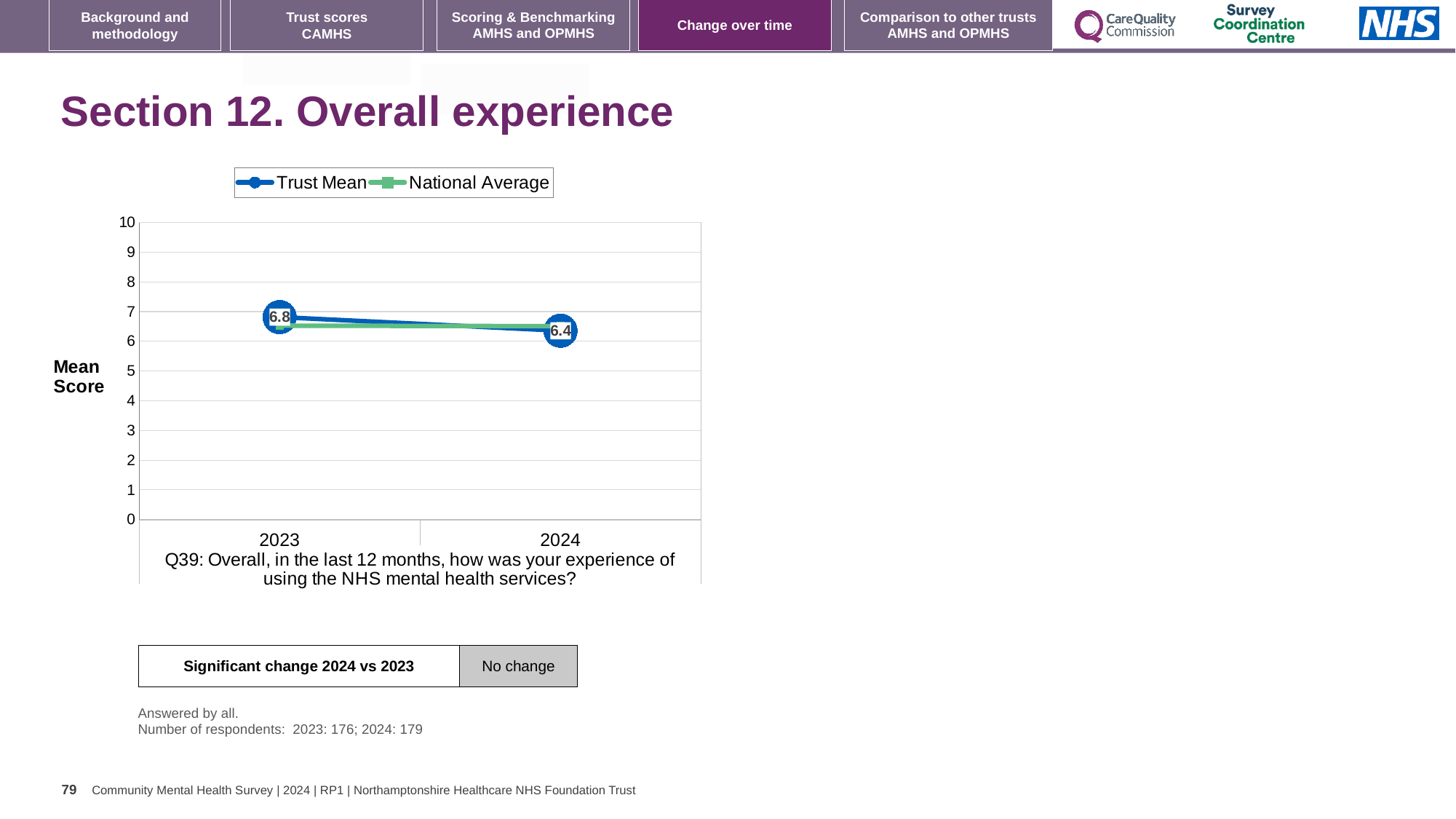
By how much did the Trust Mean change from 2023 to 2024? 0.4 Is the National Average value for 2024 greater or less than 6? greater What is the label on the y axis of the chart? Mean Score How many years are plotted on the x axis? 2 Is the National Average value for 2023 greater or less than 7? less What kind of chart is shown on the slide? line chart What is the Trust Mean value for 2024? 6.4 What is the Trust Mean value for 2023? 6.8 In which year does the Trust Mean reach its highest value? 2023 Does the Trust Mean rise or fall from 2023 to 2024? fall How many series does the legend list? 2 In which year is the Trust Mean higher, 2023 or 2024? 2023